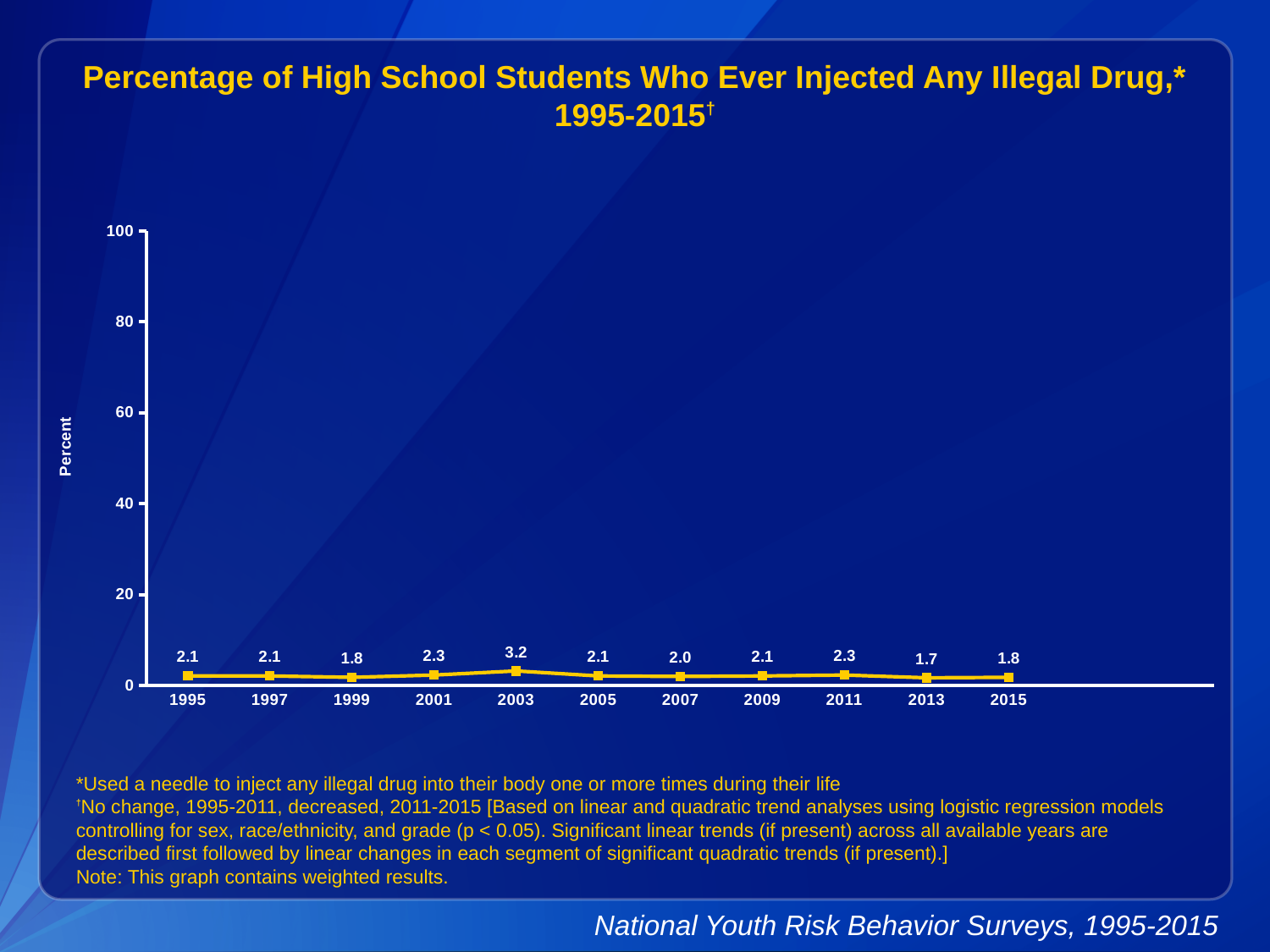
Which year has the lowest percentage? 2013 What is the label on the y axis? Percent What value is shown for 1995? 2.1 What value is shown for 2015? 1.8 What is the difference between the values for 2003 and 2013? 1.5 Is the value for 2003 greater or less than 20? less Which is larger, the value for 2001 or the value for 1999? 2001 What kind of chart is shown on the slide? line chart How many years are plotted on the x axis? 11 Which year has the highest percentage? 2003 What was the percentage of high school students who ever injected any illegal drug in 2003? 3.2 What is the maximum value shown on the y axis? 100